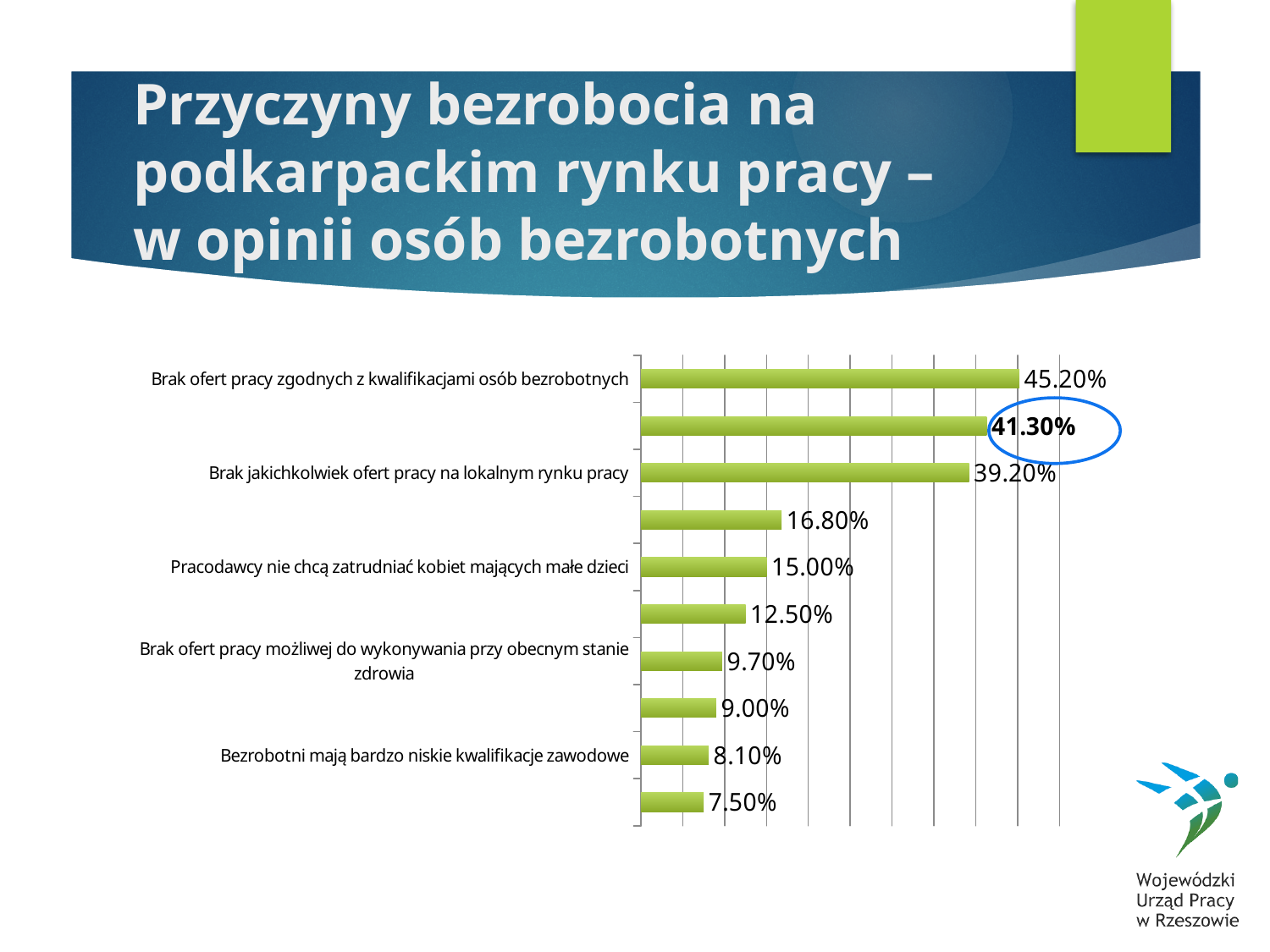
What is the lowest value shown in the chart? 7.50% What is the value for "Brak jakichkolwiek ofert pracy na lokalnym rynku pracy"? 39.20% What kind of chart is shown on the slide? bar chart What is the value for "Bezrobotni mają bardzo niskie kwalifikacje zawodowe"? 8.10% Which data label value is circled on the chart? 41.30% What is the value for "Brak ofert pracy zgodnych z kwalifikacjami osób bezrobotnych"? 45.20% What is the difference between the values for "Brak ofert pracy zgodnych z kwalifikacjami osób bezrobotnych" and "Brak jakichkolwiek ofert pracy na lokalnym rynku pracy"? 6.00% Which is larger: the value for "Pracodawcy nie chcą zatrudniać kobiet mających małe dzieci" or for "Bezrobotni mają bardzo niskie kwalifikacje zawodowe"? Pracodawcy nie chcą zatrudniać kobiet mających małe dzieci What is the value for "Pracodawcy nie chcą zatrudniać kobiet mających małe dzieci"? 15.00% What is the value for "Brak ofert pracy możliwej do wykonywania przy obecnym stanie zdrowia"? 9.70% How many bars are plotted in the chart? 10 Which category has the highest value in the chart? Brak ofert pracy zgodnych z kwalifikacjami osób bezrobotnych